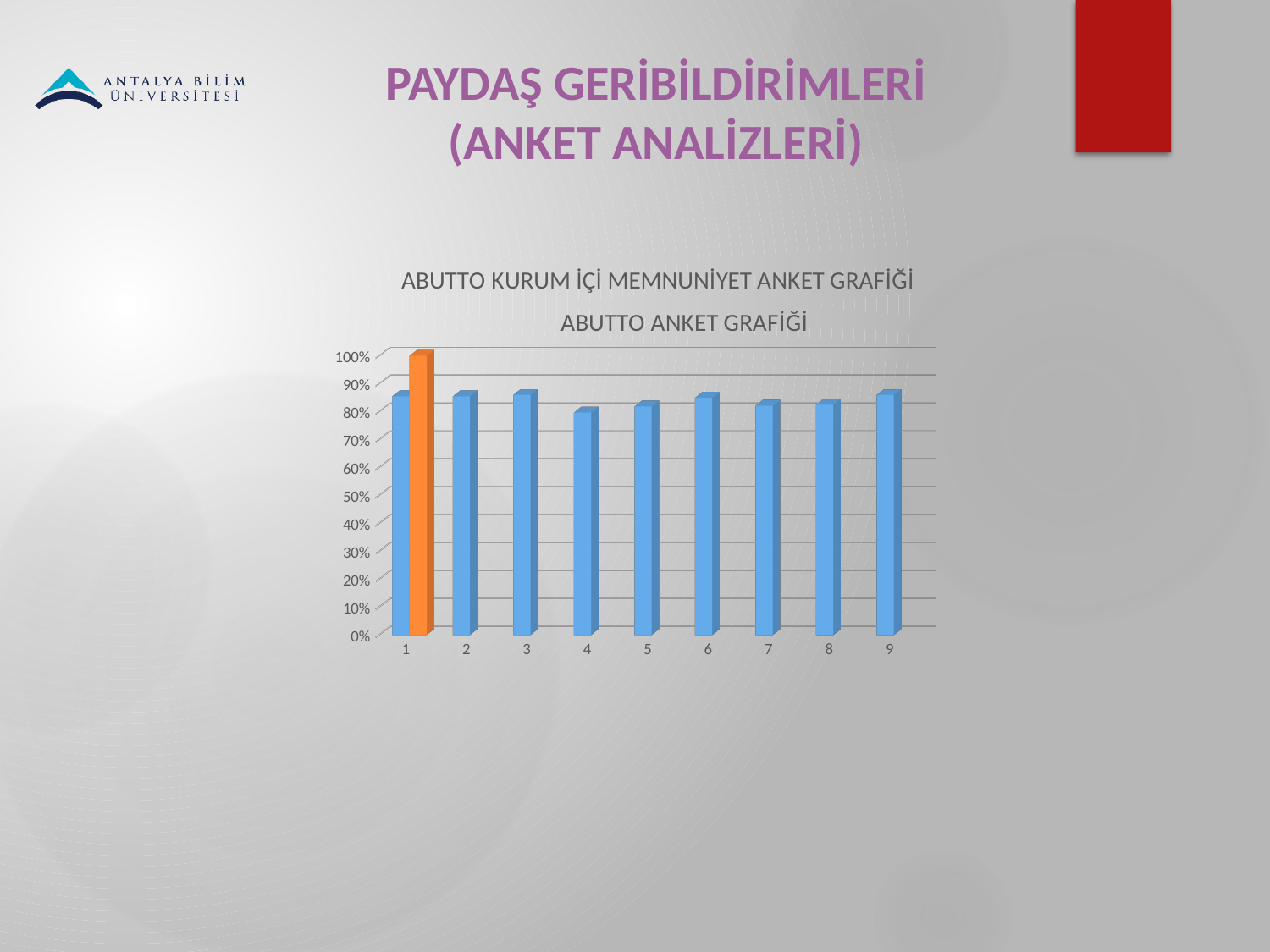
Which is larger, the blue bar for category 3 or the blue bar for category 4? category 3 Which category has the highest bar overall in the chart? 1 Is the orange bar at category 1 greater or less than 90%? greater What is the title printed directly above the plot area of the chart? ABUTTO ANKET GRAFİĞİ Is the blue bar for category 9 greater or less than 90%? less How many categories are shown on the x axis of the chart? 9 What kind of chart is shown on the slide? bar chart Is the blue bar for category 4 greater or less than 70%? greater Which category has the lowest blue bar? 4 What colour is the tallest bar in the chart? orange Which is larger, the blue bar for category 9 or the blue bar for category 4? category 9